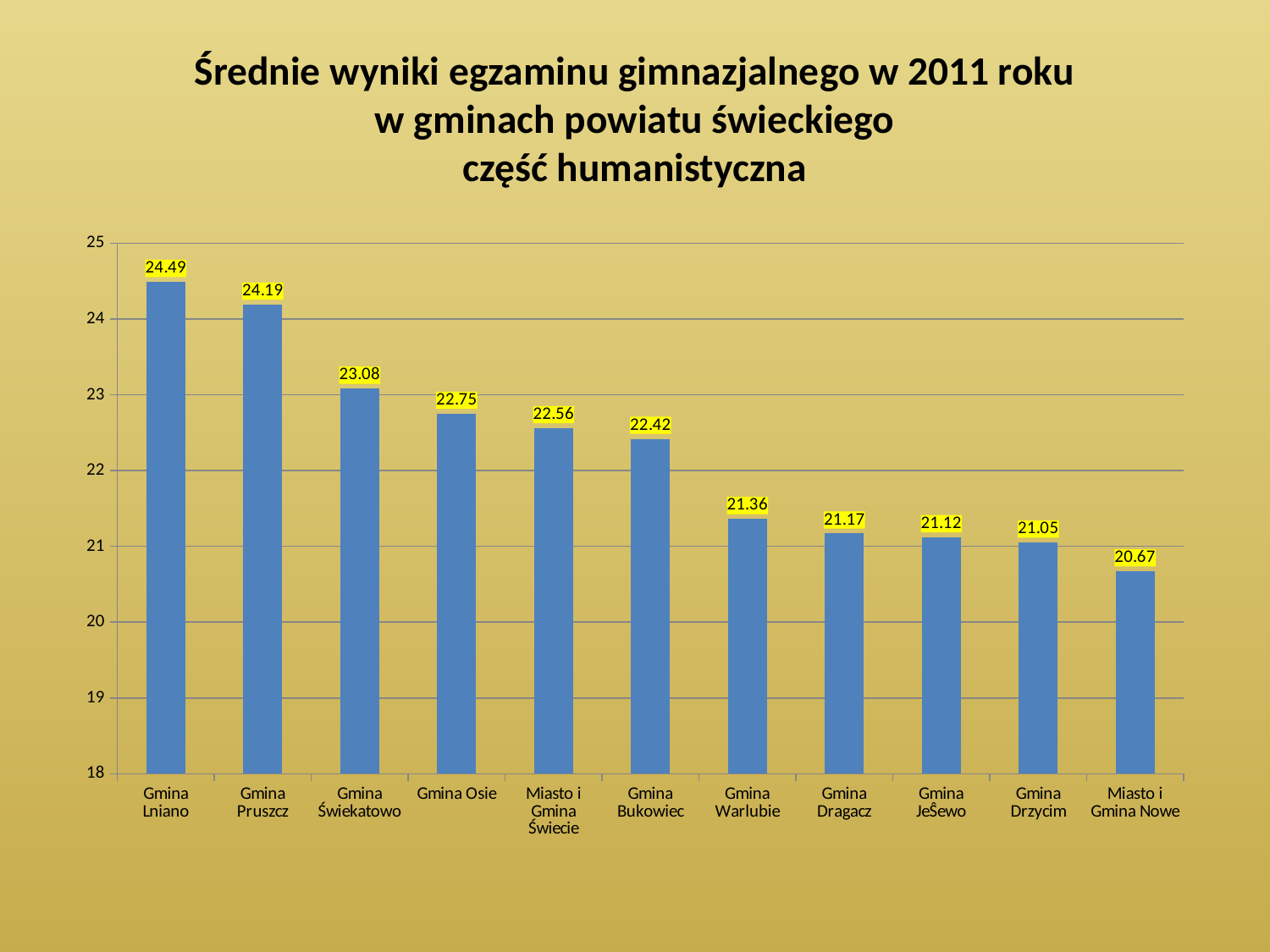
What is the value for Gmina Drzycim? 21.05 What is the value for Miasto i Gmina Świecie? 22.56 Which is larger, the value for Gmina Osie or the value for Gmina Bukowiec? Gmina Osie Do the values rise or fall from left to right along the x axis? fall What is the difference between the values for Gmina Świekatowo and Miasto i Gmina Nowe? 2.41 Which category has the lowest value? Miasto i Gmina Nowe How many categories are shown on the x axis? 11 What is the value for Gmina Lniano? 24.49 What is the difference between the values for Gmina Lniano and Gmina Pruszcz? 0.30 What kind of chart is shown on the slide? bar chart Which category has the highest value? Gmina Lniano Is the value for Gmina Warlubie greater or less than 22? less